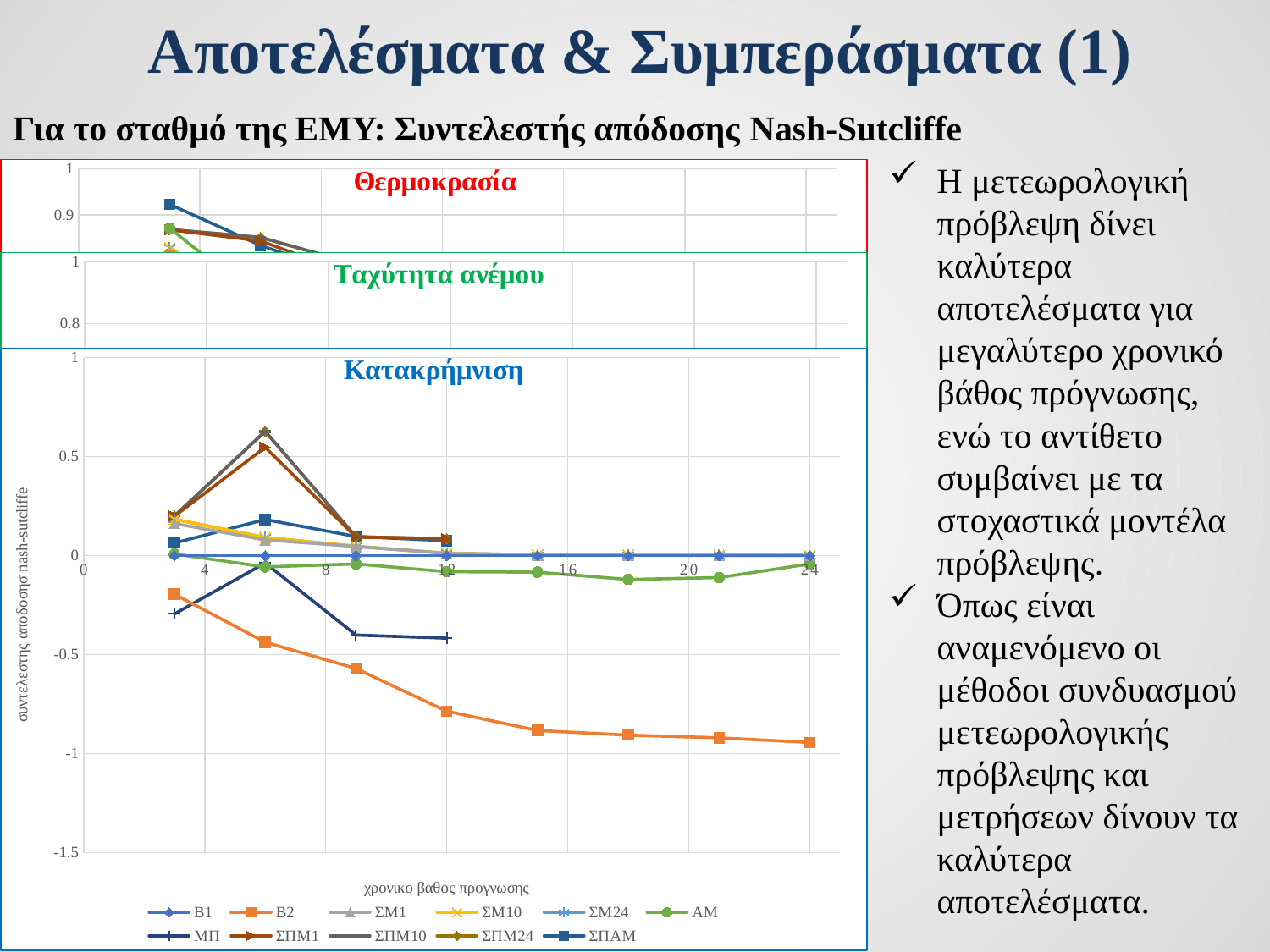
What is the x-axis title of the Κατακρήμνιση chart? χρονικο βαθος προγνωσης In the Κατακρήμνιση chart, is the value of ΣΠΜ1 at x = 6 greater or less than 0.5? greater In the Κατακρήμνιση chart, is the value of B2 at x = 12 greater or less than -0.5? less What kind of chart is the Κατακρήμνιση chart? line chart In the Κατακρήμνιση chart, is the value of ΜΠ at x = 3 greater or less than 0? less In the Κατακρήμνιση chart, which series has the lowest value at x = 24? B2 In the Κατακρήμνιση chart, do the values of B2 rise or fall as the x axis increases from 3 to 24? fall In the Κατακρήμνιση chart, which is larger at x = 6: B2 or ΣΠΜ1? ΣΠΜ1 What are the titles of the three charts on the slide, from top to bottom? Θερμοκρασία, Ταχύτητα ανέμου, Κατακρήμνιση How many series does the legend of the Κατακρήμνιση chart list? 11